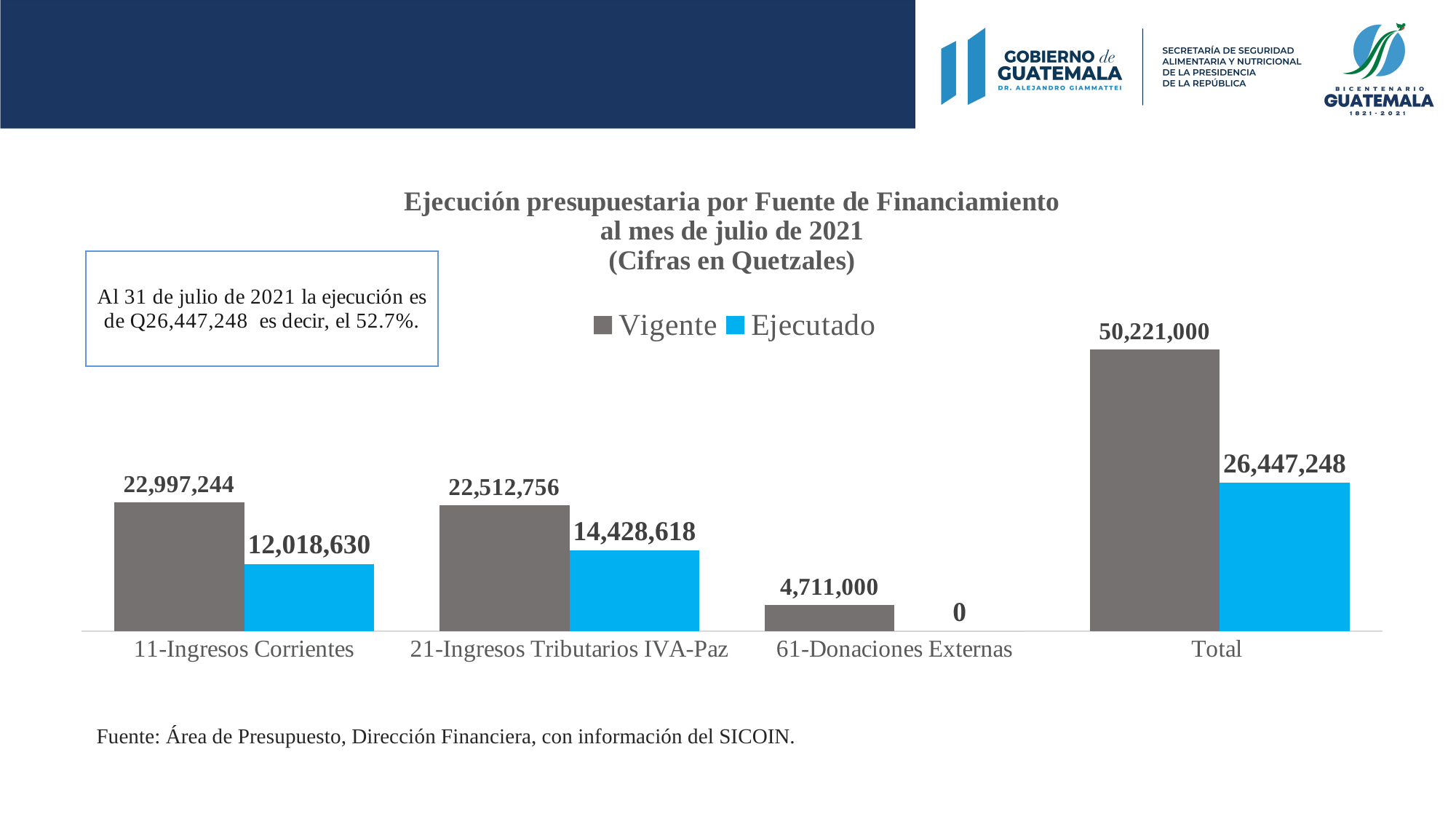
What is the Ejecutado value for 21-Ingresos Tributarios IVA-Paz? 14,428,618 What kind of chart is shown on the slide? Bar chart How many categories are shown on the x axis? 4 What is the Vigente value for 11-Ingresos Corrientes? 22,997,244 Excluding Total, which category has the highest Ejecutado value? 21-Ingresos Tributarios IVA-Paz What colour are the Ejecutado bars? Blue What is the Ejecutado value for 61-Donaciones Externas? 0 What is the Vigente value for Total? 50,221,000 What is the difference between the Vigente and Ejecutado values for 11-Ingresos Corrientes? 10,978,614 How many series does the legend list? 2 Which is larger for 21-Ingresos Tributarios IVA-Paz, the Vigente value or the Ejecutado value? Vigente Excluding Total, which category has the lowest Vigente value? 61-Donaciones Externas